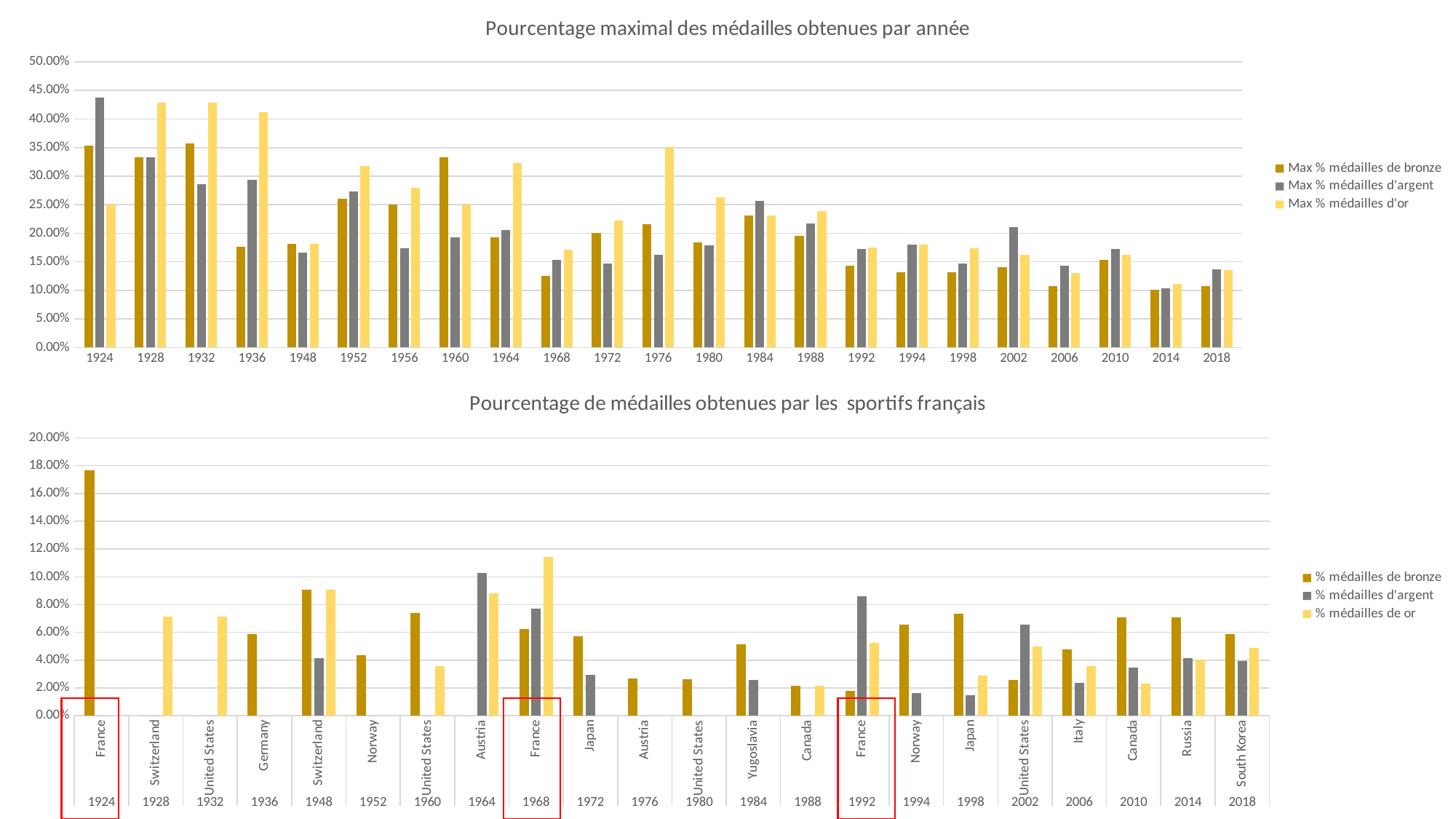
How many years are shown on the x axis of the top chart? 23 In the top chart, for 1928, which is larger: 'Max % médailles d'or' or 'Max % médailles de bronze'? Max % médailles d'or In the bottom chart, which category has the highest value for '% médailles de bronze'? France 1924 In the top chart, which year has the highest value for 'Max % médailles d'argent'? 1924 In the bottom chart, is the value for '% médailles de bronze' for France 1924 greater or less than 16.00%? greater Which three years are highlighted with red boxes on the bottom chart? 1924, 1968, 1992 In the bottom chart, for France 1968, which is larger: '% médailles de or' or '% médailles de bronze'? % médailles de or What kind of chart is the top chart, 'Pourcentage maximal des médailles obtenues par année'? Bar chart In the top chart, is the value for 'Max % médailles d'or' in 1976 greater or less than 30.00%? greater How many series does the legend of the top chart list? 3 How many categories are shown on the x axis of the bottom chart, 'Pourcentage de médailles obtenues par les sportifs français'? 22 In the top chart, is the value for 'Max % médailles de bronze' in 2014 greater or less than 15.00%? less